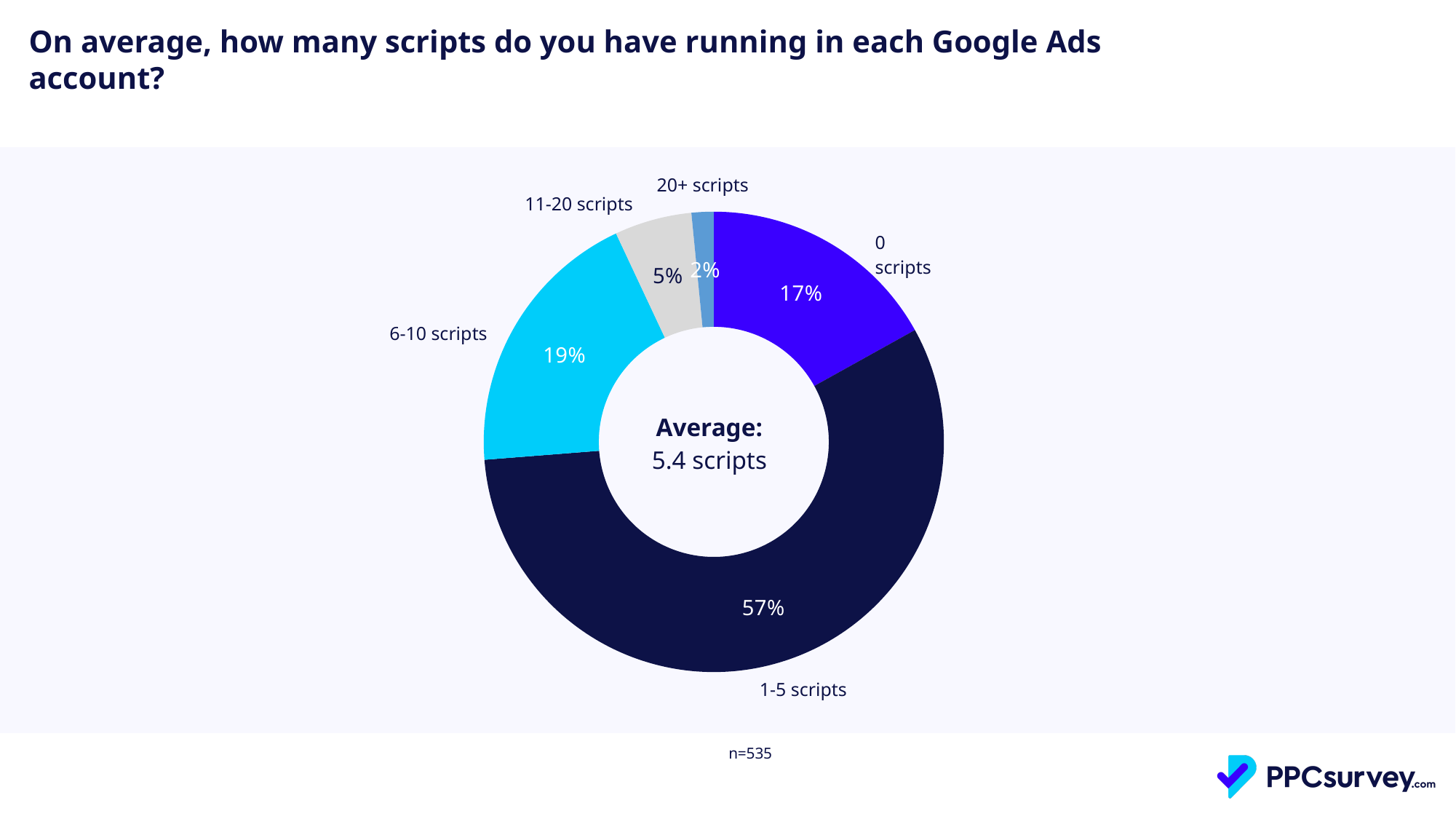
What share of respondents have 6-10 scripts running? 19% What percentage of respondents have 0 scripts running? 17% How many categories are shown in the chart? 5 Which category has the largest share of respondents? 1-5 scripts What type of chart is shown on the slide? Pie chart (donut) What average number of scripts is shown in the centre of the chart? 5.4 scripts What is the difference in percentage points between the 1-5 scripts and 6-10 scripts categories? 38 What percentage of respondents have 1-5 scripts running in each Google Ads account? 57% Which category has the smallest share of respondents? 20+ scripts Which is larger: the share for 0 scripts or the share for 6-10 scripts? 6-10 scripts What percentage of respondents have 11-20 scripts running? 5% What percentage of respondents have 20+ scripts running? 2%